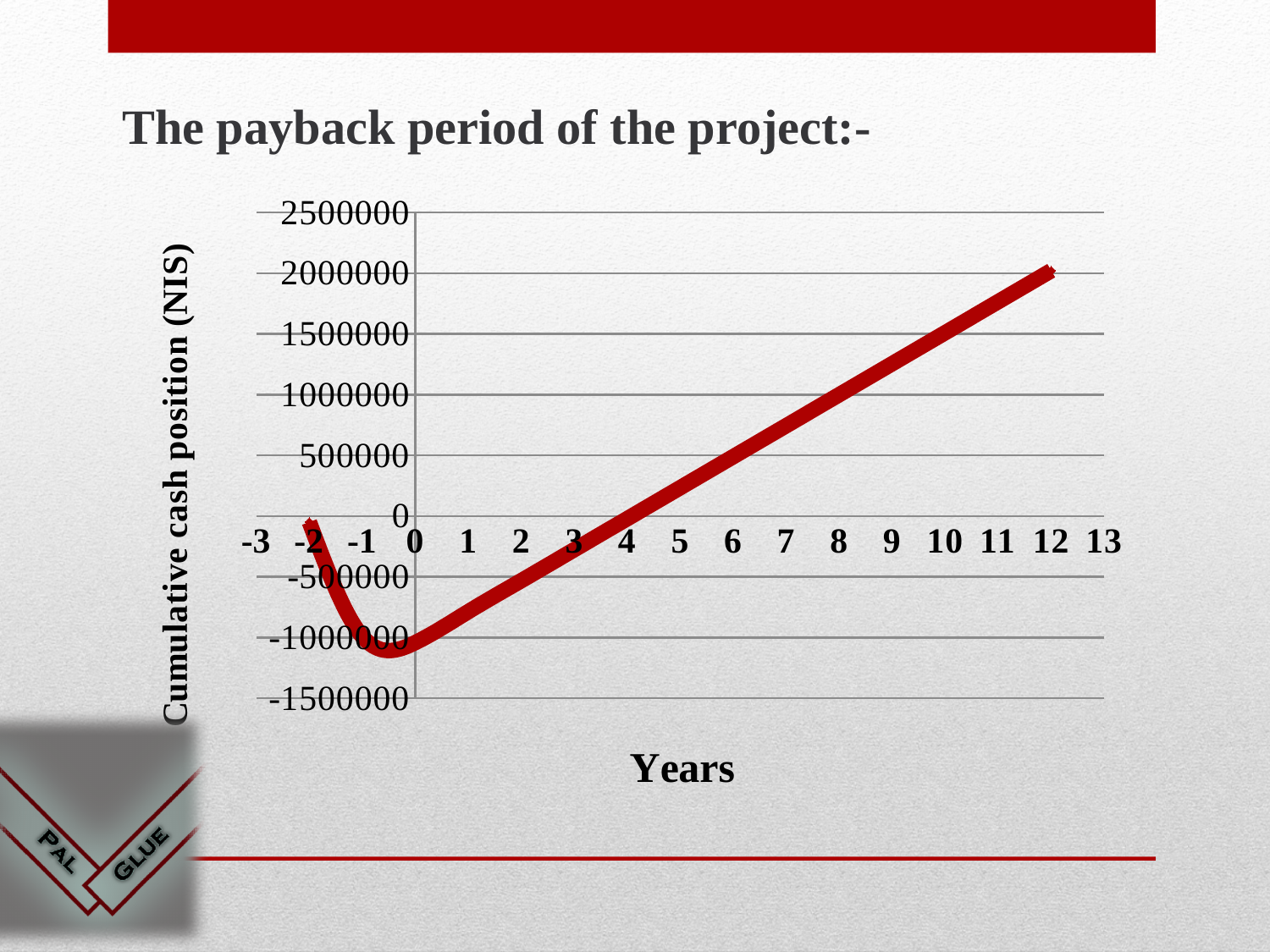
Which is larger, the cumulative cash position at year 0 or at year 12? year 12 Is the cumulative cash position at year 11 greater or less than 1500000? greater Is the cumulative cash position at year 0 greater or less than -500000? less Is the cumulative cash position at year 2 greater or less than 0? less What is the title of the chart's y axis? Cumulative cash position (NIS) Does the cumulative cash position rise or fall between year 0 and year 12? rise What is the title of the chart's x axis? Years What kind of chart is shown on the slide? line chart What is the highest value shown on the y axis? 2500000